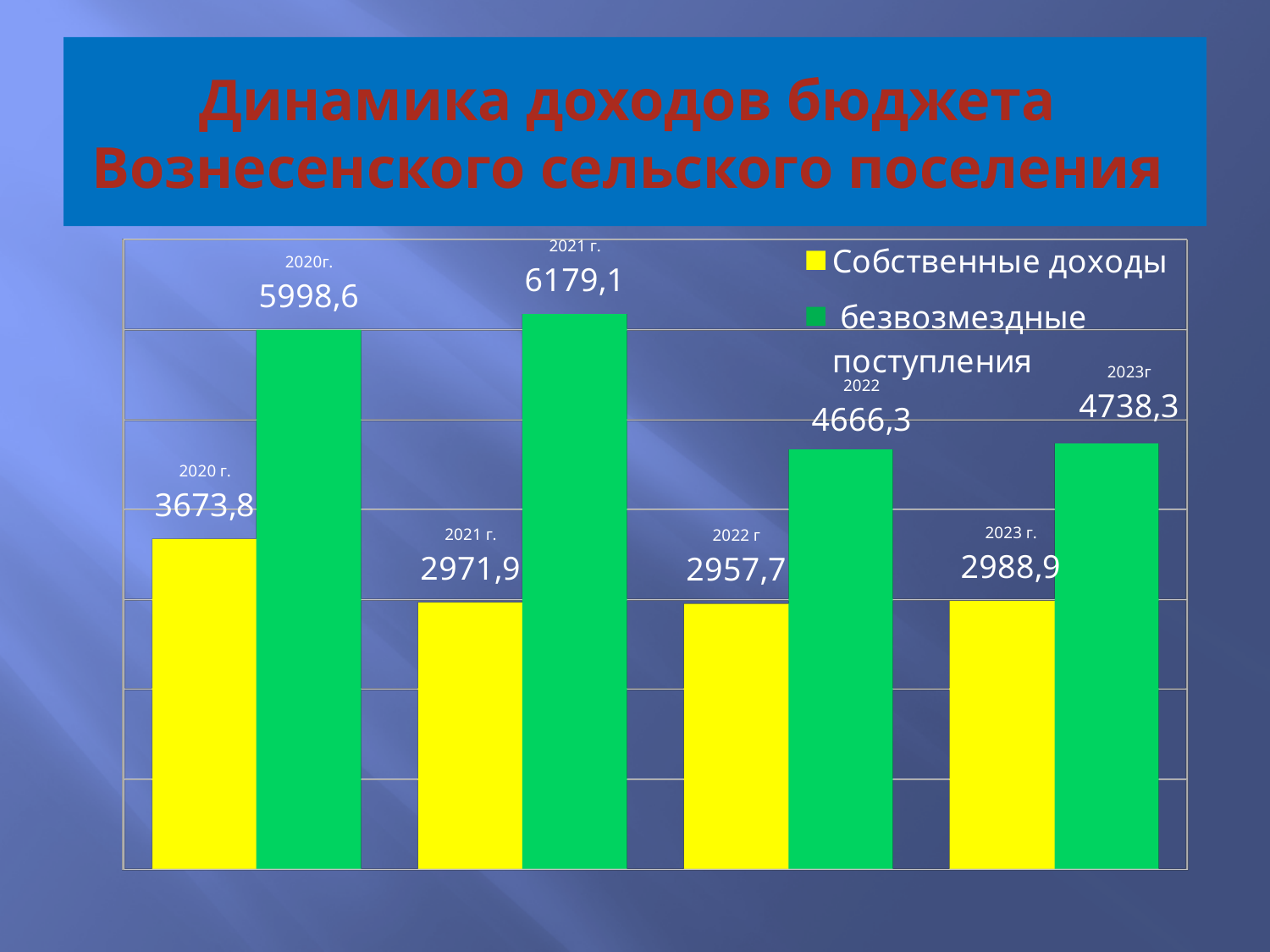
How many years are shown on the chart? 4 What is the difference between безвозмездные поступления in 2021 and in 2020? 180,5 What is the value of безвозмездные поступления for 2022? 4666,3 What is the value of Собственные доходы for 2020? 3673,8 In which year is безвозмездные поступления the highest? 2021 What type of chart is shown on the slide? Bar chart What is the value of Собственные доходы for 2023? 2988,9 Which is larger in 2023: Собственные доходы or безвозмездные поступления? безвозмездные поступления In which year is безвозмездные поступления the lowest? 2022 How many series does the legend list? 2 In which year is Собственные доходы the highest? 2020 What is the value of безвозмездные поступления for 2021? 6179,1